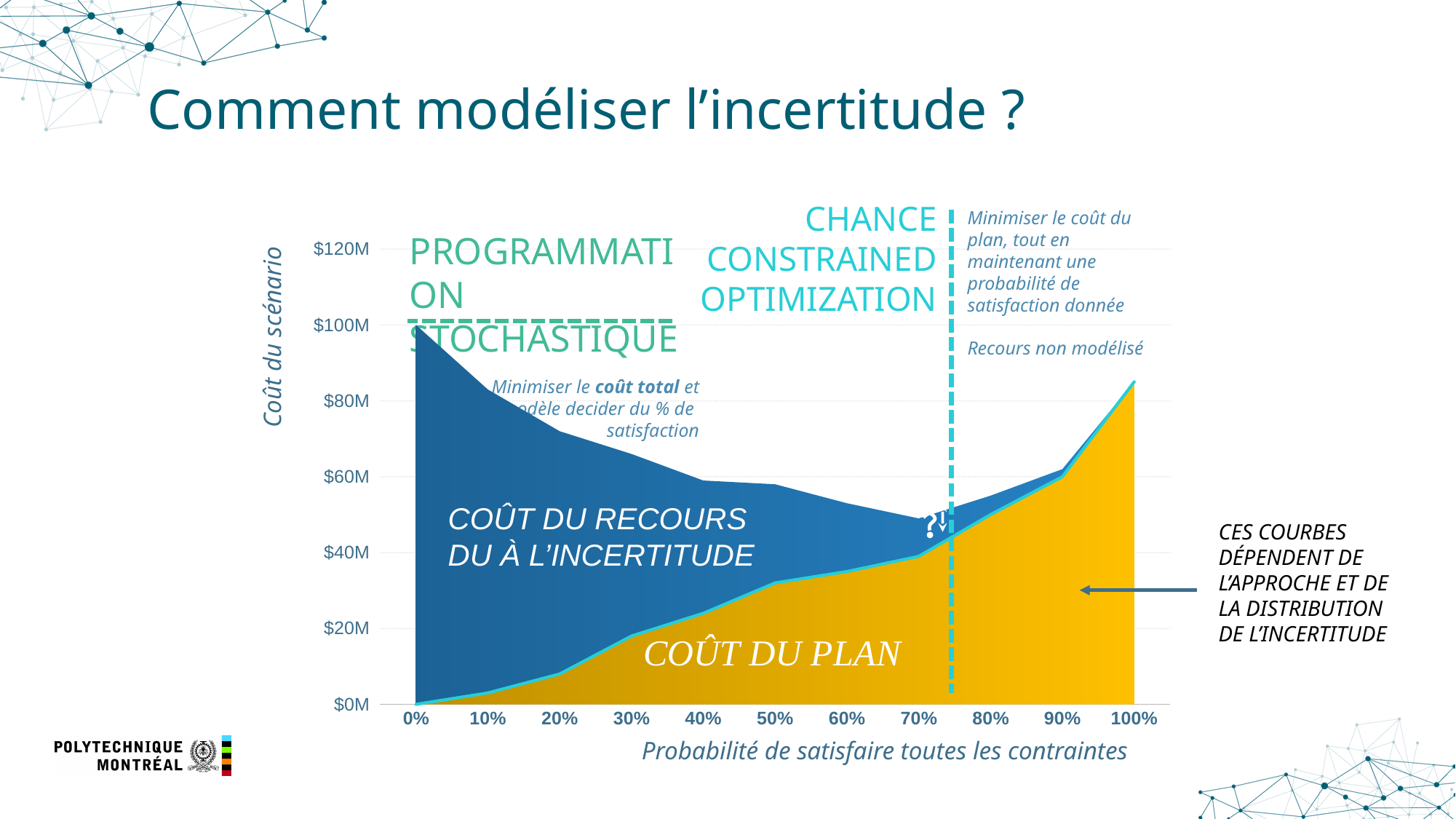
Is the total scenario cost (top of the blue area) at 60% greater or less than $60M? less At which probability is the 'Coût du plan' highest? 100% Is the 'Coût du plan' at 100% greater or less than $80M? greater At which probability is the 'Coût du plan' lowest? 0% What kind of chart is shown on the slide? Area chart Is the 'Coût du plan' at 50% greater or less than $20M? greater Which is larger at 10%: the 'Coût du plan' or the 'Coût du recours dû à l'incertitude'? Coût du recours dû à l'incertitude How many tick labels are shown on the x axis? 11 What is the label of the x axis? Probabilité de satisfaire toutes les contraintes What is the label of the y axis? Coût du scénario Does the 'Coût du plan' area rise or fall as the probability increases from 0% to 100%? Rises